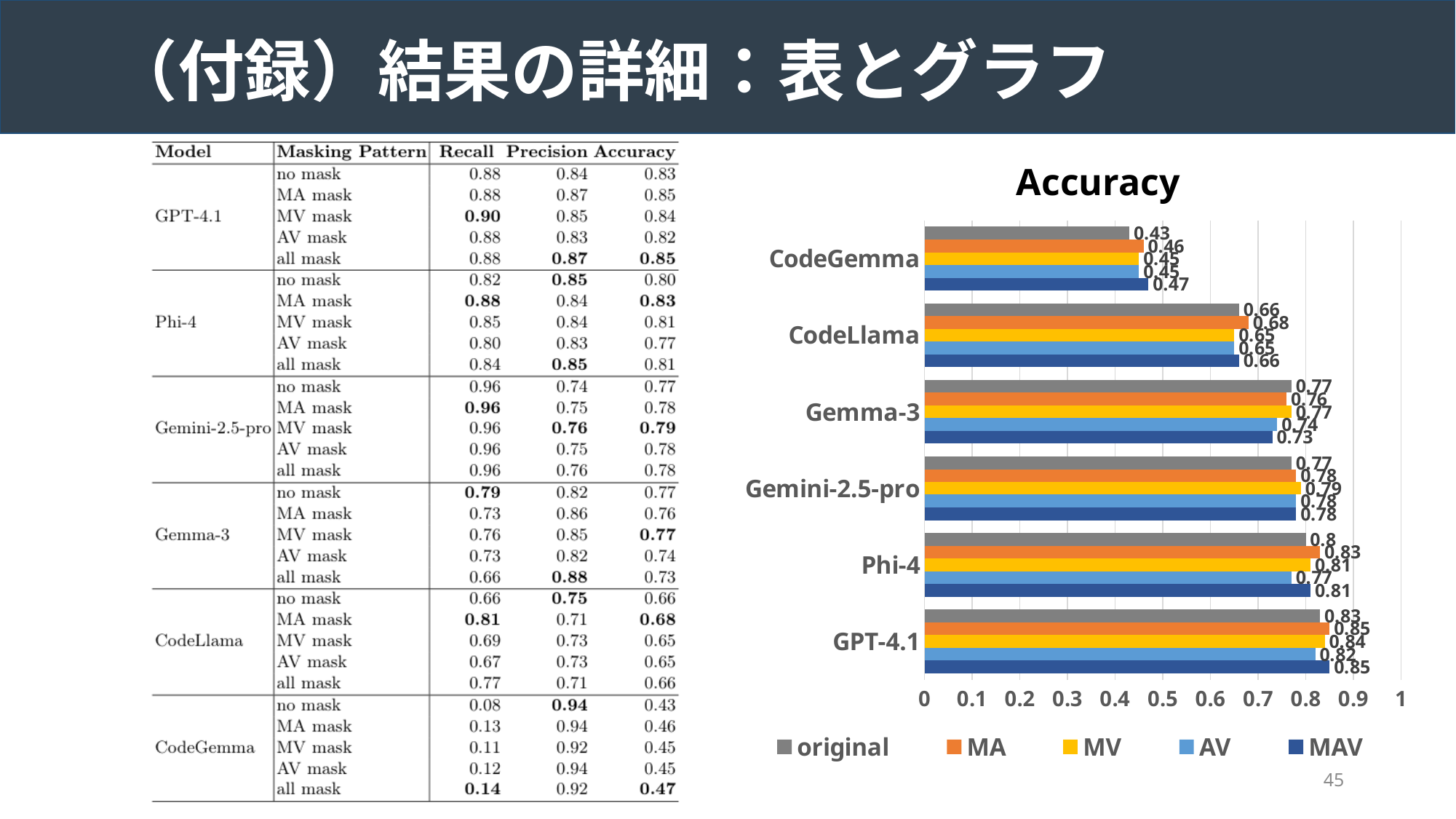
What is the MAV accuracy value for CodeGemma in the Accuracy chart? 0.47 In the Accuracy chart, which is larger: the AV value for Phi-4 or the AV value for Gemma-3? Phi-4 What is the original accuracy value for Phi-4 in the Accuracy chart? 0.8 How many series does the legend of the Accuracy chart list? 5 How many models are shown on the y axis of the Accuracy chart? 6 Is the MAV accuracy for CodeLlama greater or less than 0.5 in the Accuracy chart? greater What type of chart is the Accuracy chart? Bar chart What is the difference between the MA accuracy of GPT-4.1 and the MA accuracy of CodeGemma in the Accuracy chart? 0.39 Which model has the highest MA accuracy in the Accuracy chart? GPT-4.1 Which model has the lowest original accuracy in the Accuracy chart? CodeGemma What is the MV accuracy value for Gemini-2.5-pro in the Accuracy chart? 0.79 What is the MA accuracy value for GPT-4.1 in the Accuracy chart? 0.85